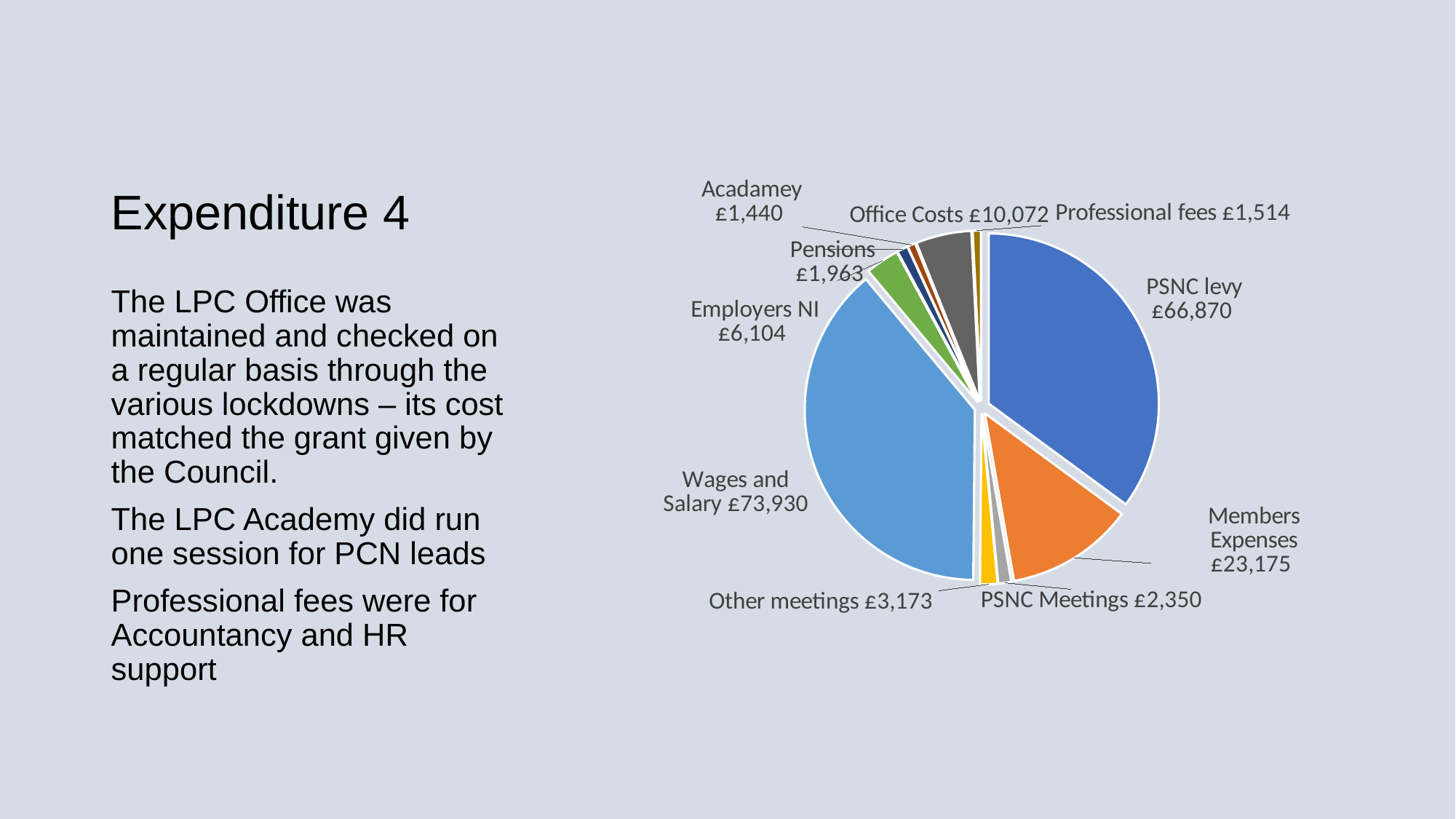
What colour is the Members Expenses slice? Orange What is the value for Office Costs? £10,072 Which category has the smallest value in the pie chart? Acadamey What is the difference between Employers NI and Pensions? £4,141 Which category has the largest slice of the pie? Wages and Salary What is the value for Wages and Salary? £73,930 What type of chart is shown on the slide? Pie chart How many slices does the pie chart have? 10 What is the value for PSNC levy? £66,870 Which is larger, Other meetings or PSNC Meetings? Other meetings What is the difference between Wages and Salary and PSNC levy? £7,060 What is the value for Members Expenses? £23,175